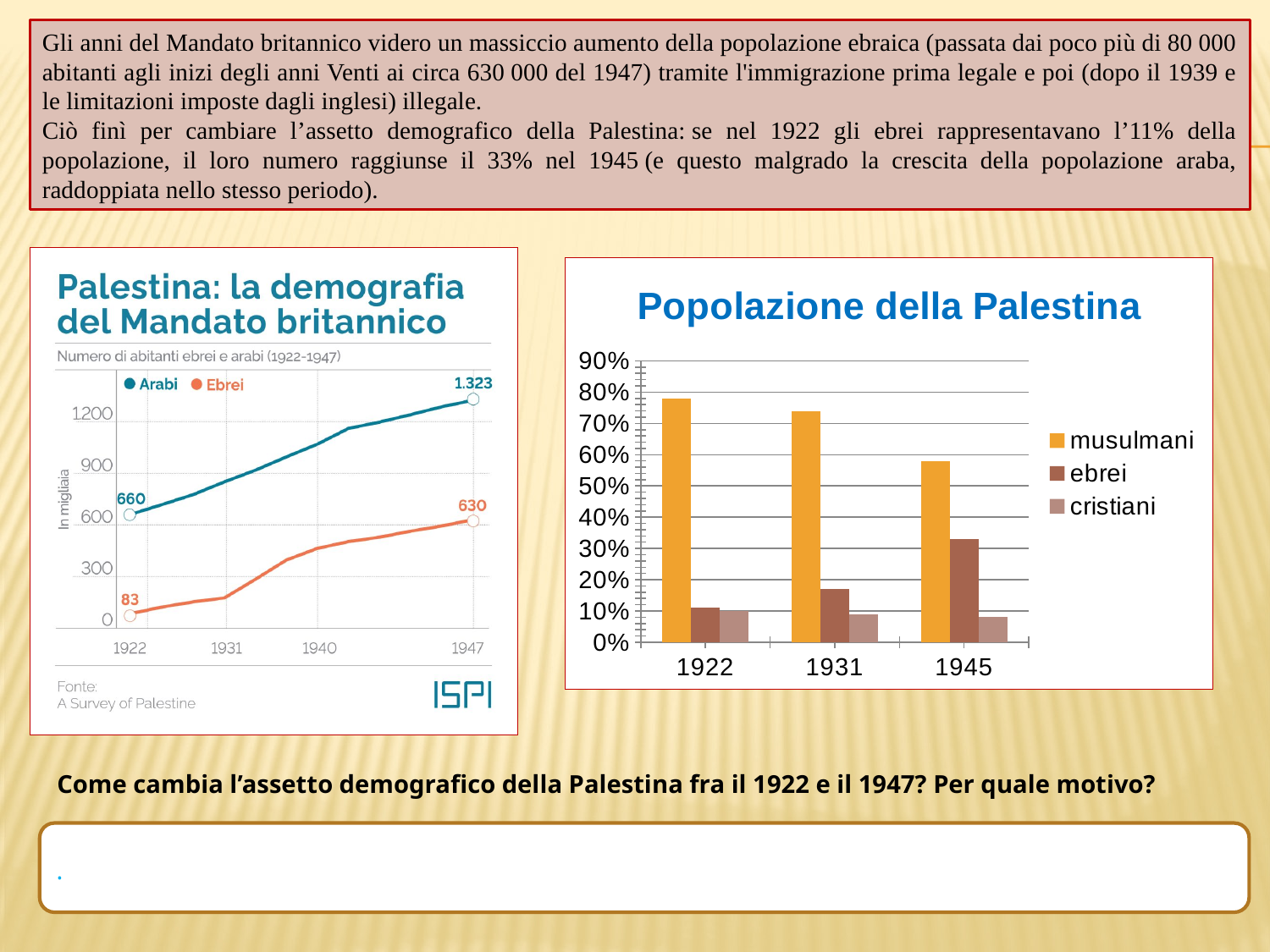
In the chart titled 'Palestina: la demografia del Mandato britannico', how many series does the legend list? 2 In the chart titled 'Popolazione della Palestina', which series has the highest value in 1945? musulmani In the chart titled 'Palestina: la demografia del Mandato britannico', what is the value for Ebrei in 1947? 630 In the chart titled 'Palestina: la demografia del Mandato britannico', what is the value for Arabi in 1922? 660 In the chart titled 'Popolazione della Palestina', how many series does the legend list? 3 In the chart titled 'Palestina: la demografia del Mandato britannico', by how much did the Arabi value grow between 1922 and 1947? 663 What kind of chart is 'Palestina: la demografia del Mandato britannico'? line chart In the chart titled 'Palestina: la demografia del Mandato britannico', what is the value for Arabi in 1947? 1.323 In the chart titled 'Palestina: la demografia del Mandato britannico', what is the value for Ebrei in 1922? 83 In the chart titled 'Popolazione della Palestina', is the value for musulmani in 1922 greater or less than 70%? greater What kind of chart is 'Popolazione della Palestina'? bar chart In the chart titled 'Palestina: la demografia del Mandato britannico', do the Ebrei values rise or fall from 1922 to 1947? rise